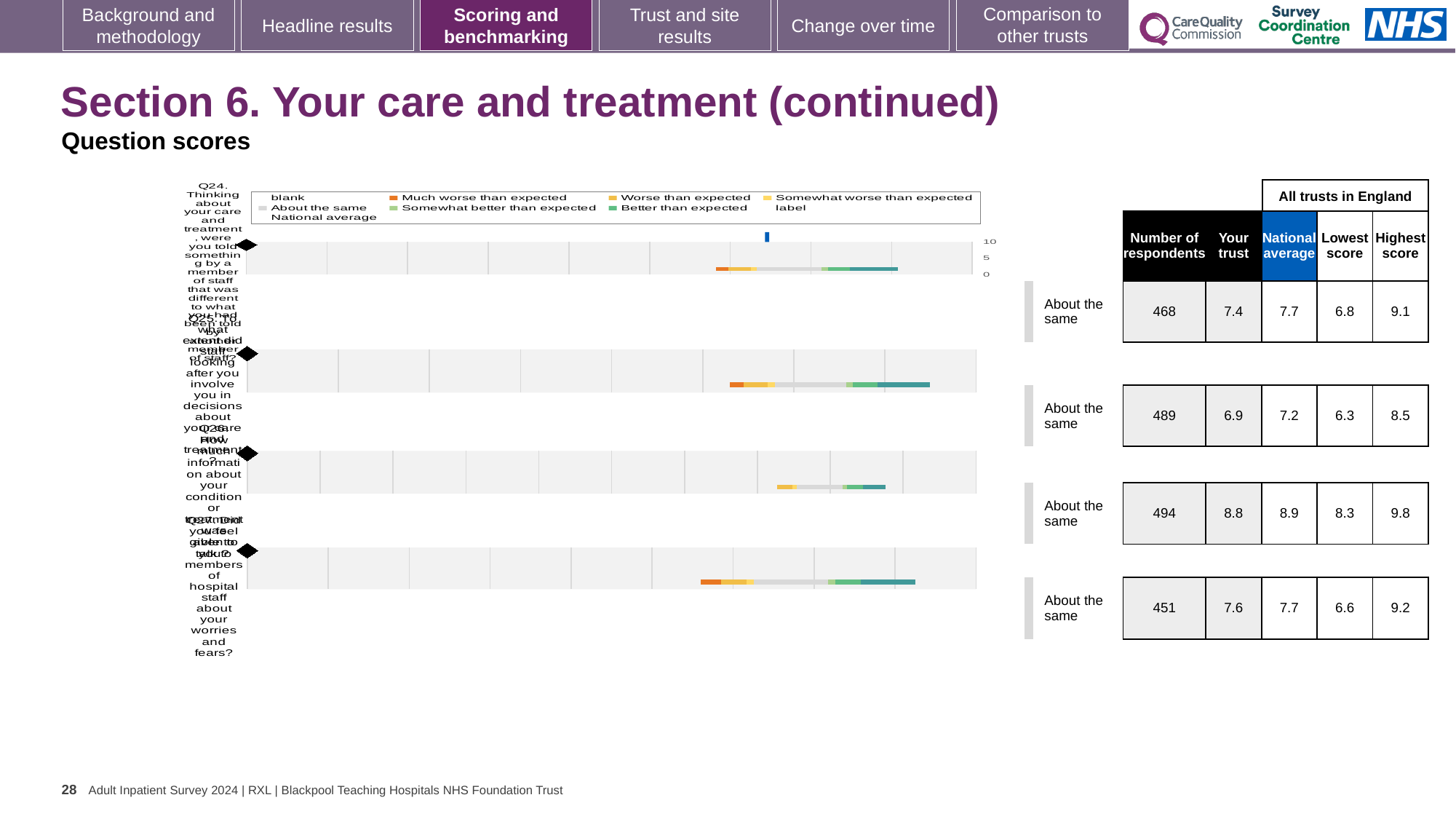
What is the 'Your trust' score for Q24 shown in the table next to the chart? 7.4 Which question has the highest 'Your trust' score on this slide? Q26 What benchmark category is shown for Q27 on this slide? About the same Which legend entry in the chart is shown in dark orange? Much worse than expected How many respondents are listed for Q26? 494 Which question has the lowest 'Your trust' score on this slide? Q25 How many questions (rows) are plotted in the chart on this slide? 4 What is the difference between the national average and the 'Your trust' score for Q24? 0.3 What is the national average score for Q25 shown on the slide? 7.2 What type of chart is used to show the question scores on this slide? bar chart For Q26, which is larger: the 'Your trust' score or the national average? National average What is the highest score across all trusts in England for Q27? 9.2